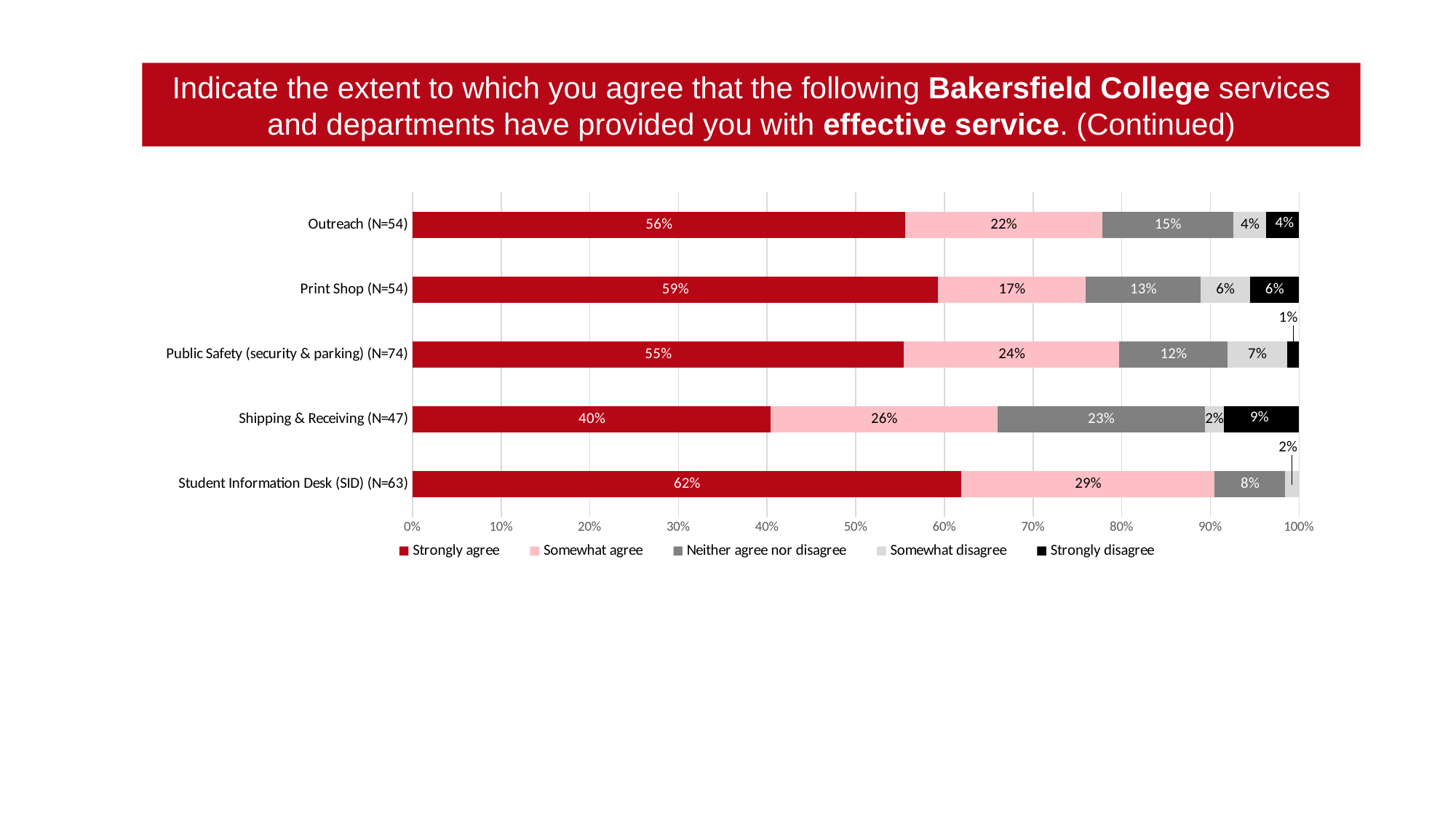
How many services are shown on the chart? 5 Which service has the highest Strongly disagree percentage? Shipping & Receiving (N=47) What is the difference between the Strongly agree percentages for Student Information Desk (SID) and Shipping & Receiving? 22% How many response categories does the legend list? 5 Which service has the lowest Strongly agree percentage? Shipping & Receiving (N=47) What percentage of Public Safety (security & parking) respondents somewhat disagree? 7% Which service has the highest Strongly agree percentage? Student Information Desk (SID) (N=63) Which has a larger Somewhat agree percentage, Outreach or Public Safety (security & parking)? Public Safety (security & parking) What percentage of Outreach respondents strongly agree? 56% What percentage of Shipping & Receiving respondents neither agree nor disagree? 23% What type of chart is shown on the slide? Stacked bar chart What percentage of Print Shop respondents strongly disagree? 6%